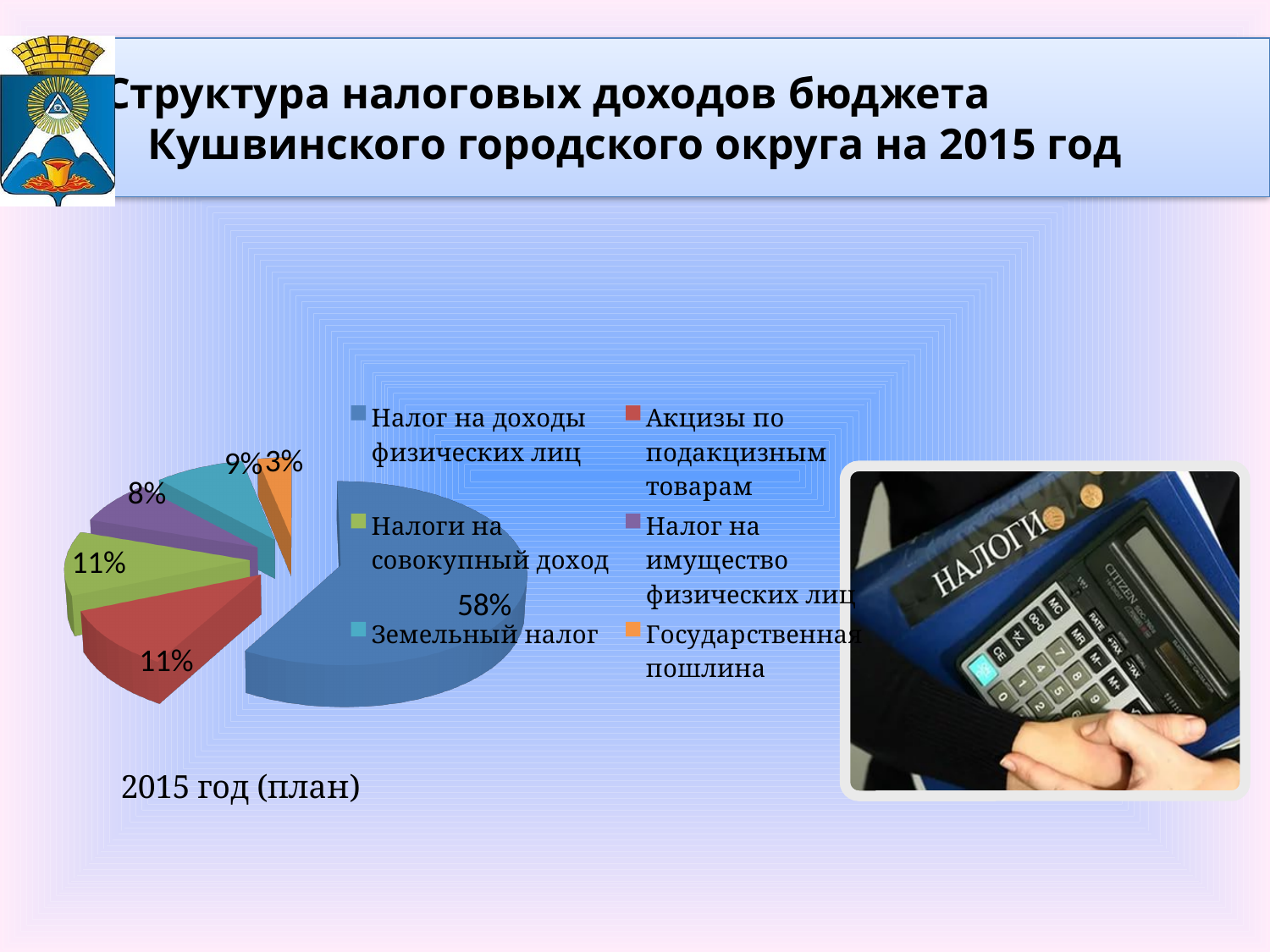
What is the difference in percentage points between Налог на доходы физических лиц and Земельный налог? 49 Which category has the largest slice of the pie? Налог на доходы физических лиц Which is larger, the share for Земельный налог or the share for Налог на имущество физических лиц? Земельный налог What type of chart is shown on the slide? pie chart How many categories does the pie chart have? 6 What share of the pie does Налог на имущество физических лиц have? 8% What share of the pie does Налог на доходы физических лиц have? 58% What share of the pie does Акцизы по подакцизным товарам have? 11% What caption appears below the pie chart? 2015 год (план) Which category has the smallest slice of the pie? Государственная пошлина